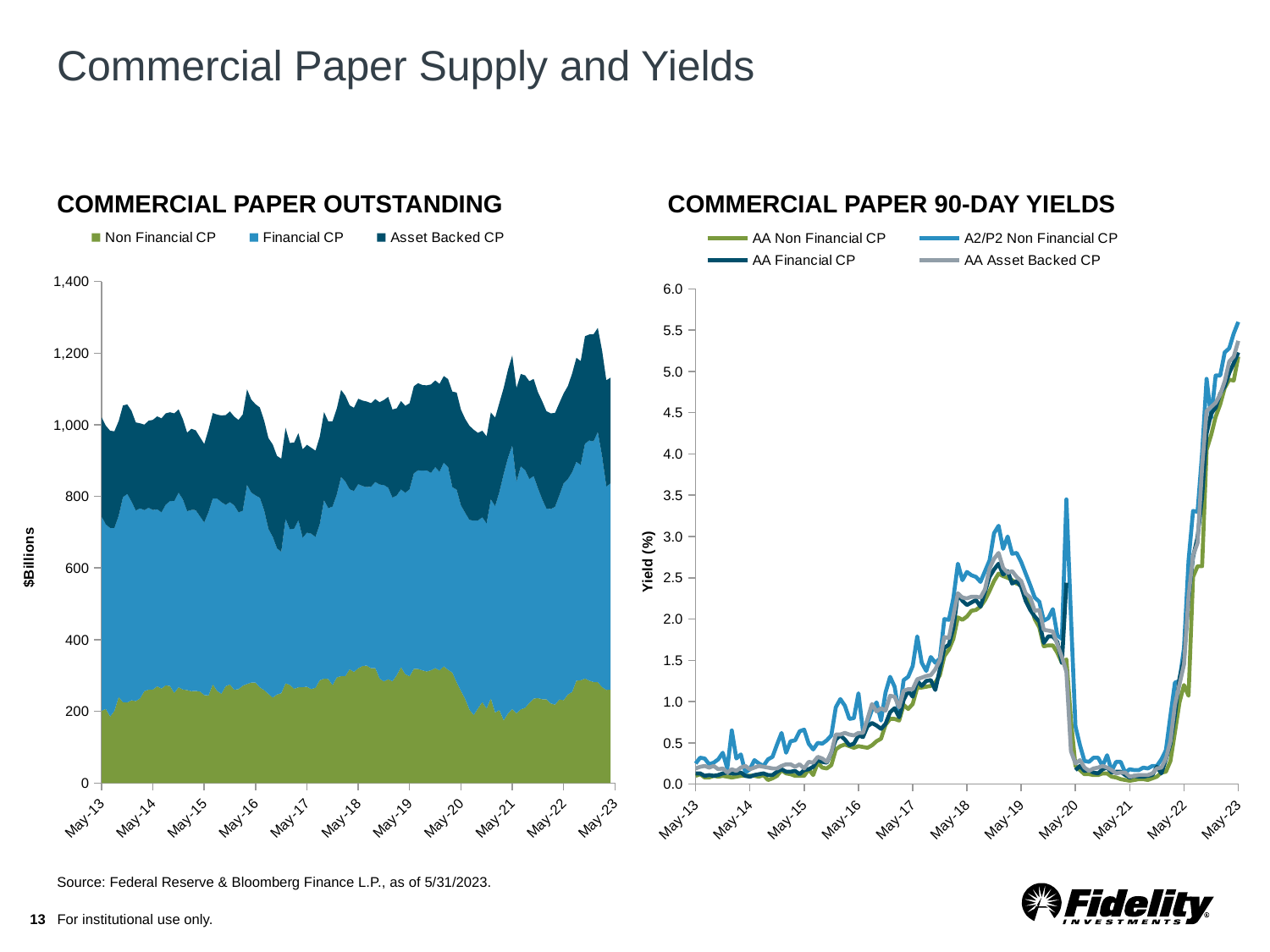
What is the y-axis label of the COMMERCIAL PAPER OUTSTANDING chart? $Billions In the COMMERCIAL PAPER 90-DAY YIELDS chart, do yields rise or fall between May-21 and May-23? Rise How many series does the legend of the COMMERCIAL PAPER 90-DAY YIELDS chart list? 4 In the COMMERCIAL PAPER OUTSTANDING chart, is the value for Non Financial CP at May-23 greater or less than 400? less How many series does the legend of the COMMERCIAL PAPER OUTSTANDING chart list? 3 In the COMMERCIAL PAPER 90-DAY YIELDS chart, are the yields at May-21 greater or less than 0.5? less What kind of chart is the COMMERCIAL PAPER 90-DAY YIELDS chart? Line chart What kind of chart is the COMMERCIAL PAPER OUTSTANDING chart? Stacked area chart In the COMMERCIAL PAPER OUTSTANDING chart, does the total outstanding ever exceed 1,400? No What is the y-axis label of the COMMERCIAL PAPER 90-DAY YIELDS chart? Yield (%)